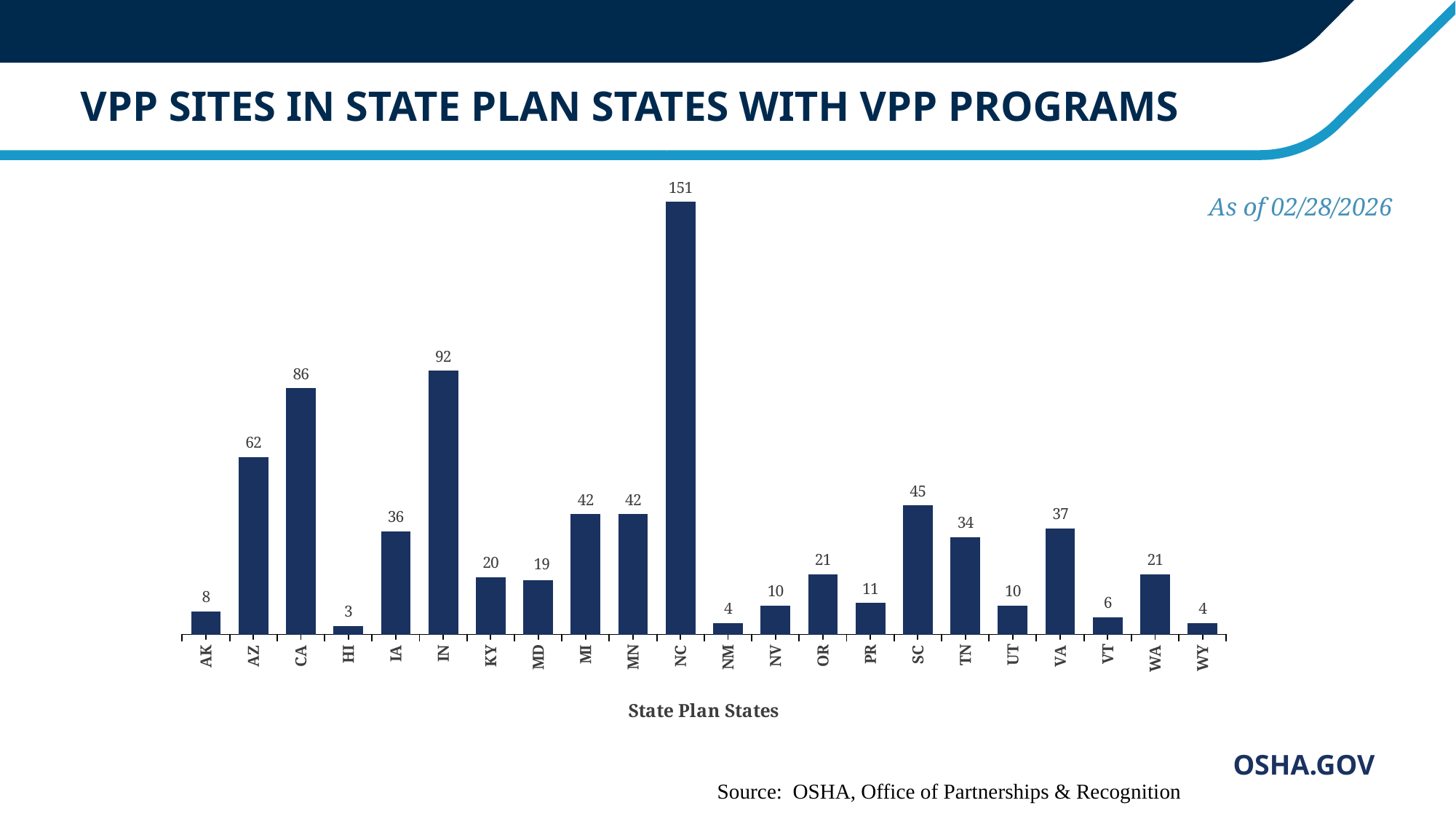
How many states are shown on the x axis? 22 What is the difference between the values for CA and AZ? 24 Which state has the lowest number of VPP sites? HI What is the value shown for SC? 45 What is the value shown for IN? 92 Which has a larger value, VA or TN? VA Which state has the highest number of VPP sites? NC What is the x-axis title of the chart? State Plan States Which has a larger value, IA or KY? IA What is the difference between the values for NC and IN? 59 What kind of chart is shown on the slide? Bar chart How many VPP sites does NC have? 151